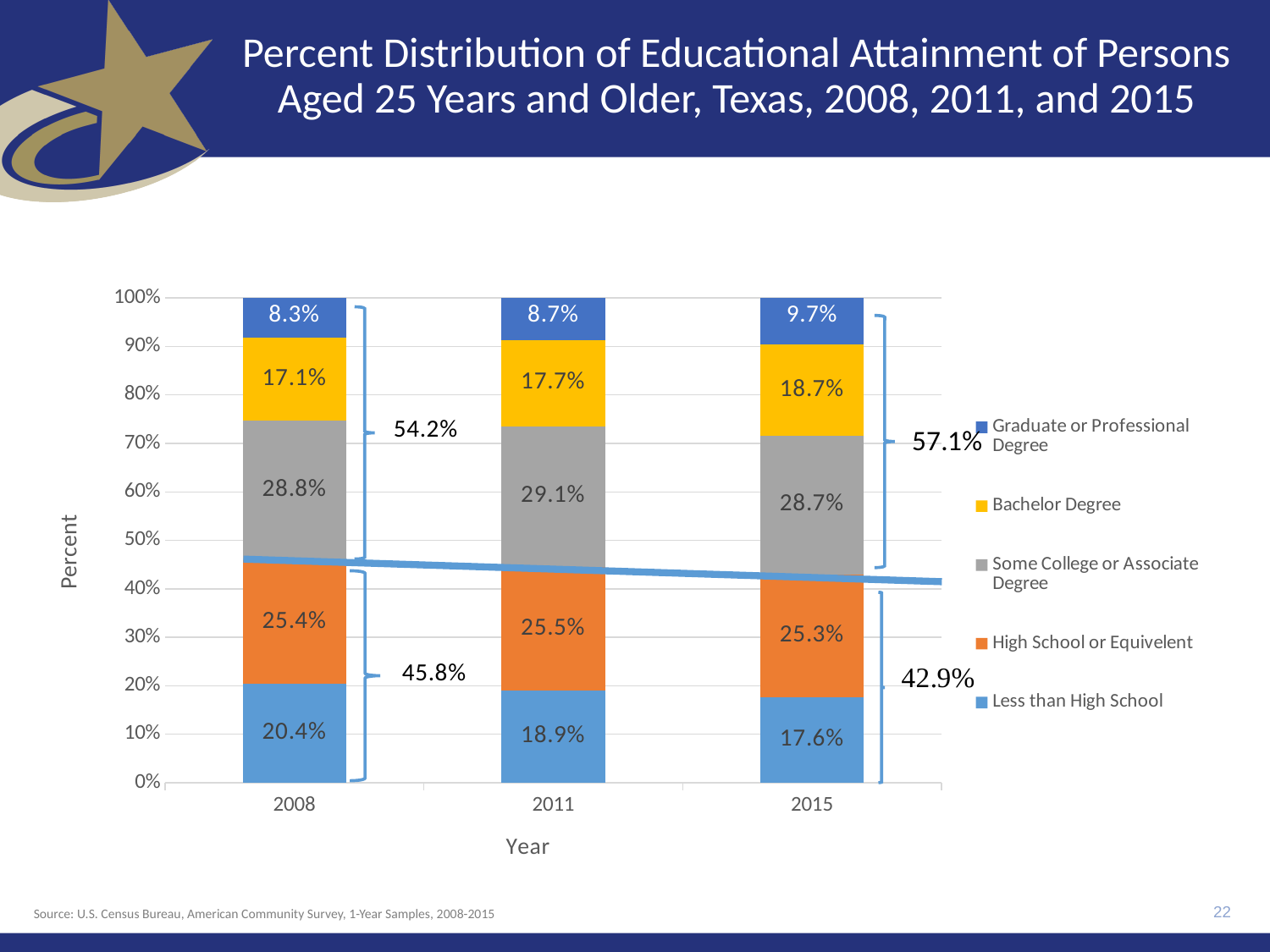
By how many percentage points did the Bachelor Degree share increase from 2008 to 2015? 1.6% What combined percentage is annotated for the top three categories (Some College or Associate Degree and above) in 2008? 54.2% Which year has the larger Some College or Associate Degree share, 2011 or 2015? 2011 In which year is the Graduate or Professional Degree share the highest? 2015 How many years are shown on the x axis? 3 How many educational attainment categories does the legend list? 5 What is the value for Less than High School in 2008? 20.4% What is the value for Graduate or Professional Degree in 2011? 8.7% What kind of chart is shown on the slide? Stacked bar chart In which year is the Less than High School share the lowest? 2015 What percentage of persons aged 25 and older in Texas had a Bachelor Degree in 2015? 18.7% Does the Less than High School share rise or fall from 2008 to 2015? Fall